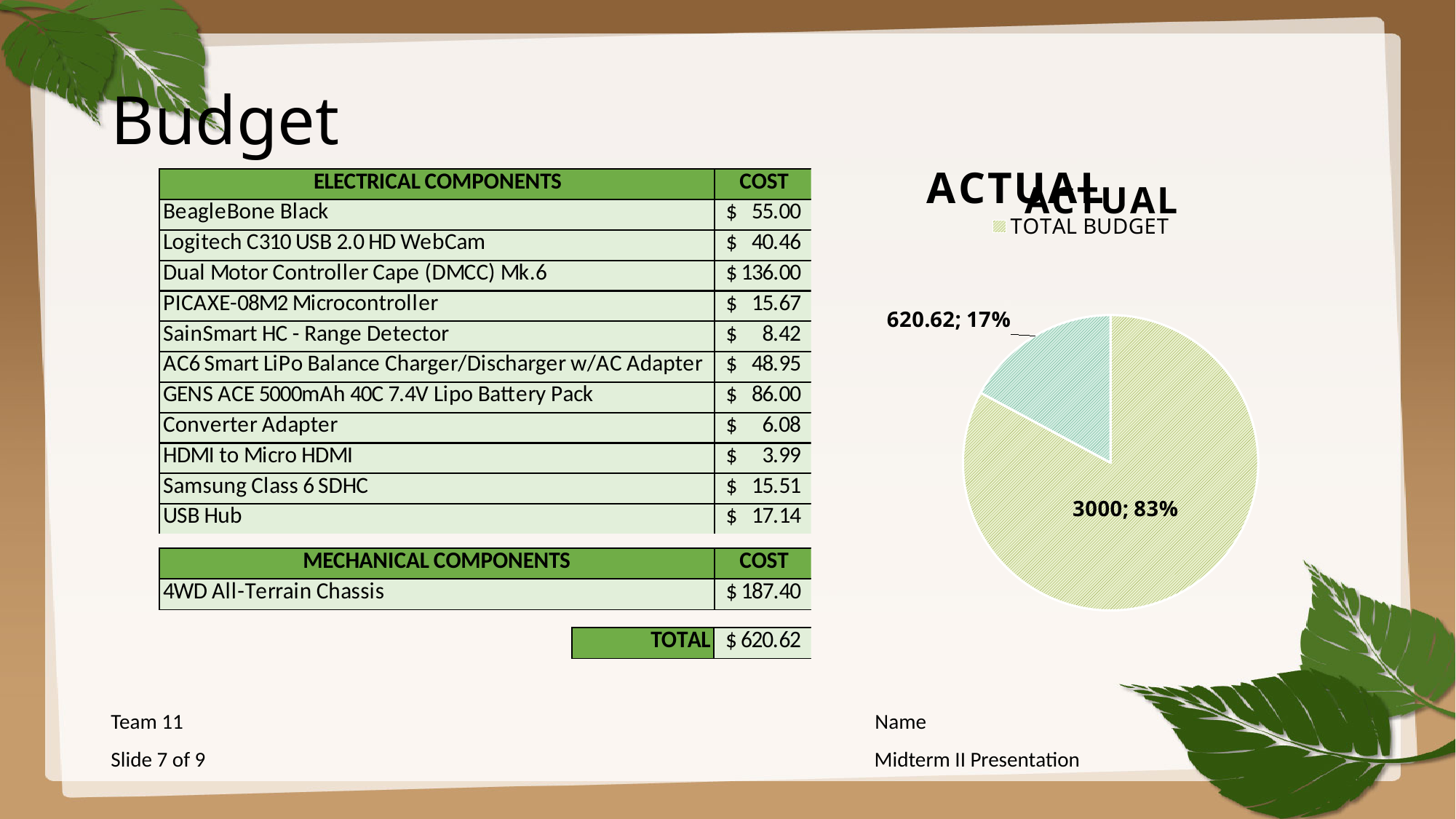
Which slice of the pie chart is the largest? TOTAL BUDGET In the pie chart, which is larger: the ACTUAL slice or the TOTAL BUDGET slice? TOTAL BUDGET What kind of chart is shown on the right side of the slide? pie chart What share of the pie does the TOTAL BUDGET slice represent? 83% In the pie chart, what value is labelled on the ACTUAL slice? 620.62 How many entries does the pie chart's legend list? 2 How many slices does the pie chart have? 2 Which slice of the pie chart is the smallest? ACTUAL What is the difference between the TOTAL BUDGET value and the ACTUAL value in the pie chart? 2379.38 What are the two legend entries of the pie chart? ACTUAL and TOTAL BUDGET In the pie chart, what value is labelled on the TOTAL BUDGET slice? 3000 What share of the pie does the ACTUAL slice represent? 17%